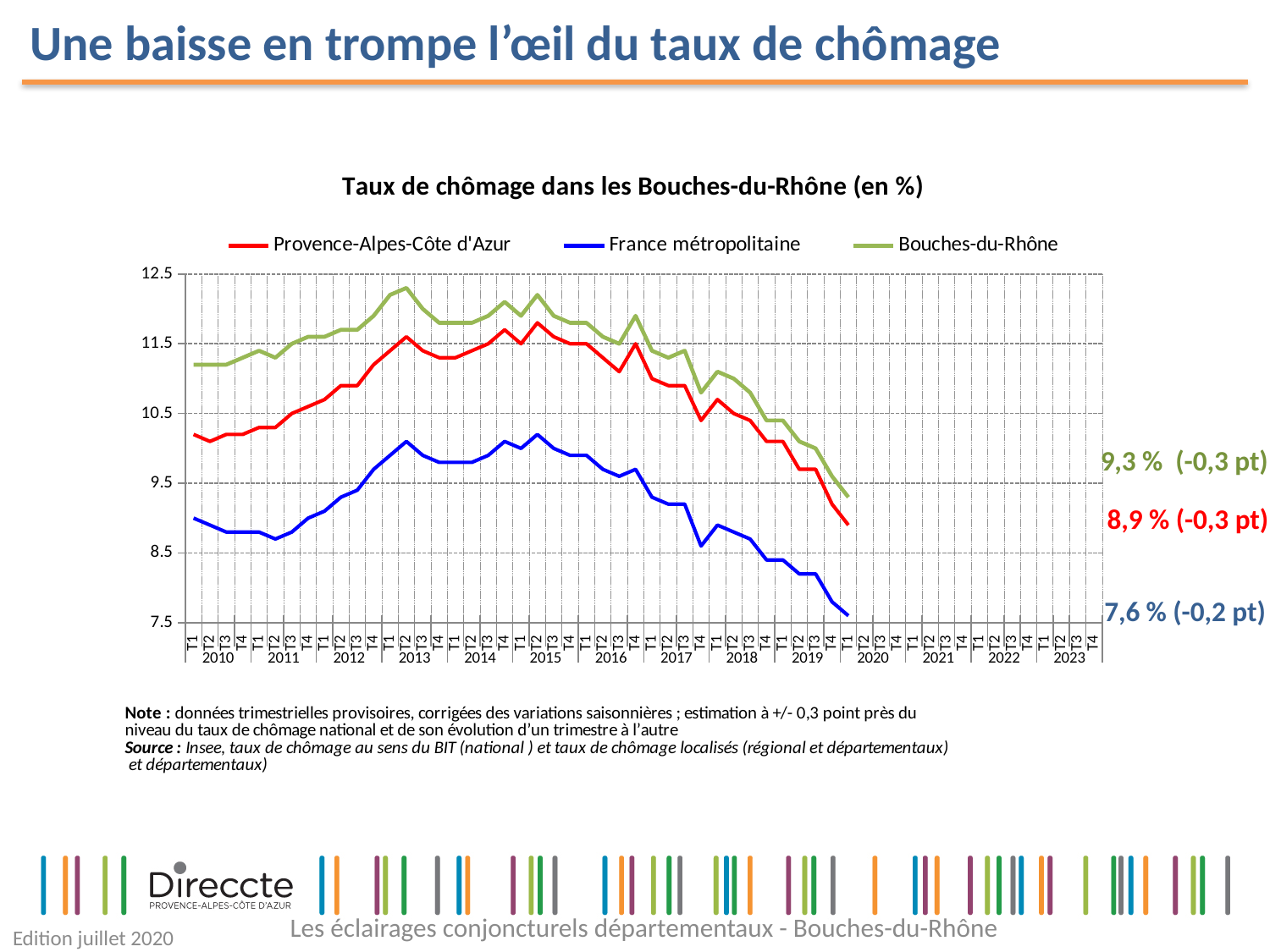
What is the latest unemployment rate shown for Provence-Alpes-Côte d'Azur? 8,9 % At the end of the series, which is higher: Bouches-du-Rhône or France métropolitaine? Bouches-du-Rhône By how many points did the France métropolitaine rate change in the latest quarter, according to the label? -0,2 pt How many series does the legend list? 3 Is the value for France métropolitaine in T1 2010 greater or less than 9.5? less What is the difference between the latest rates for Bouches-du-Rhône (9,3 %) and Provence-Alpes-Côte d'Azur (8,9 %)? 0,4 points Is the value for Bouches-du-Rhône in T2 2013 greater or less than 11.5? greater What is the latest unemployment rate shown for Bouches-du-Rhône? 9,3 % What is the latest unemployment rate shown for France métropolitaine? 7,6 % Which series has the highest values across the whole period? Bouches-du-Rhône From 2016 to 2020, does the France métropolitaine line rise or fall overall? fall What kind of chart is shown on the slide? line chart